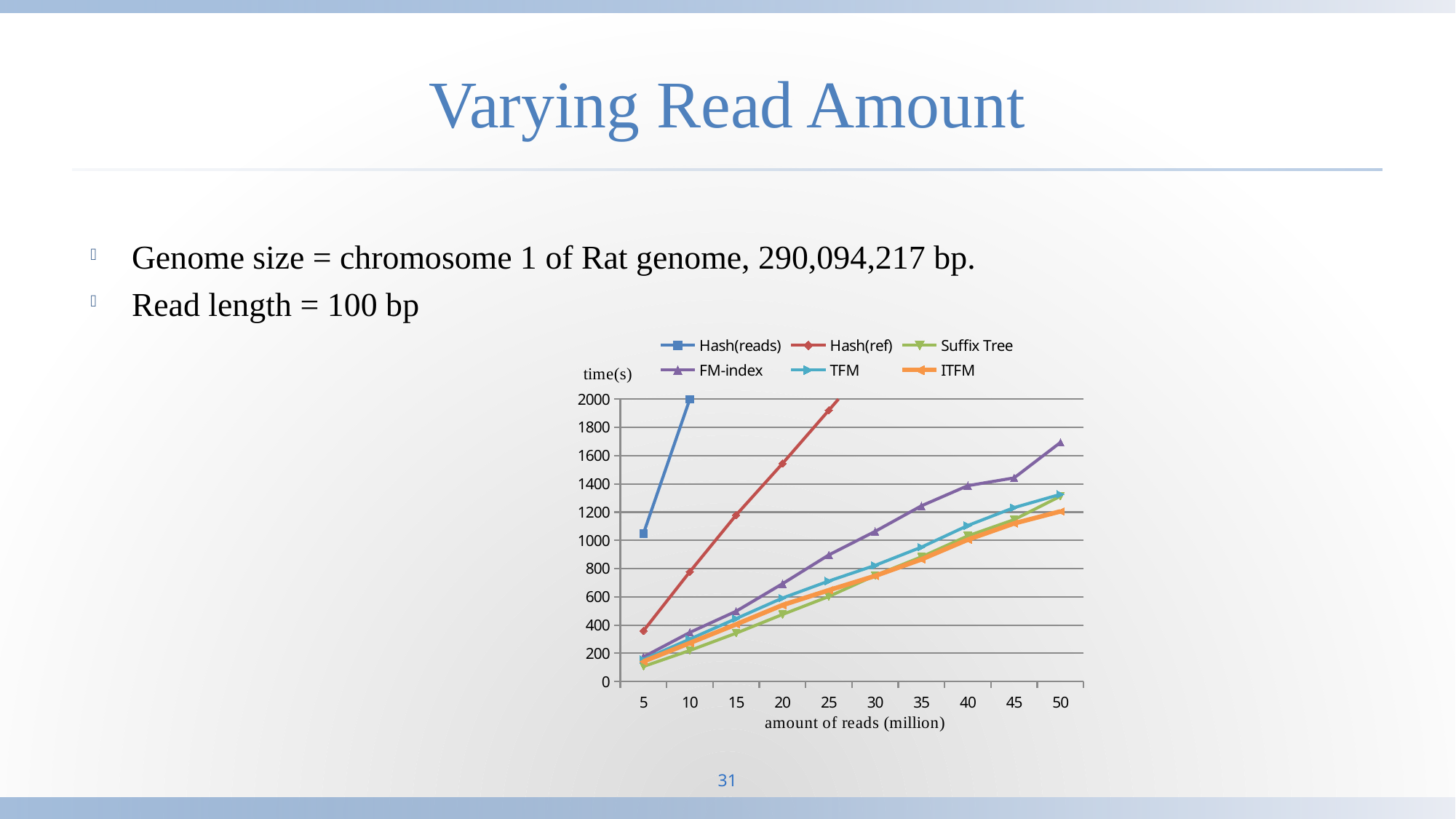
At 5 million reads, which is larger: Hash(reads) or Hash(ref)? Hash(reads) Is the value for FM-index at 25 million reads greater or less than 1000? less Is the value for Suffix Tree at 5 million reads greater or less than 200? less At 50 million reads, which is larger: FM-index or TFM? FM-index Does the time for FM-index rise or fall as the amount of reads increases? rise Which series has the lowest time at 50 million reads? ITFM Is the value for Hash(reads) at 5 million reads greater or less than 800? greater How many values are marked on the x axis (amount of reads)? 10 How many series does the legend list? 6 What kind of chart is shown on the slide? line chart